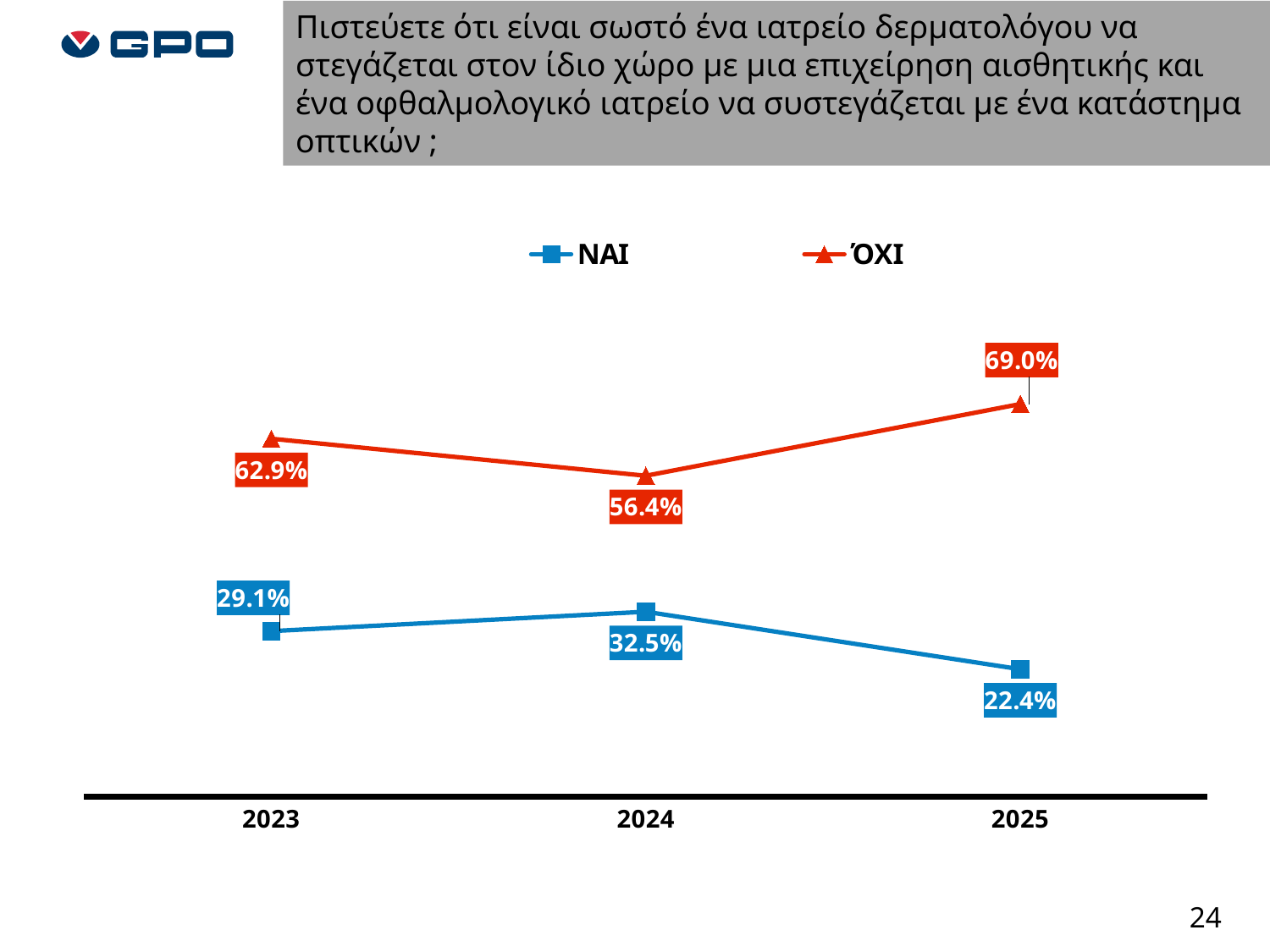
How many series does the legend list? 2 What is the value for ΝΑΙ in 2025? 22.4% What is the difference between the ΌΧΙ and ΝΑΙ values in 2025? 46.6% What is the value for ΌΧΙ in 2023? 62.9% Which is larger in 2024, the ΝΑΙ value or the ΌΧΙ value? ΌΧΙ What is the value for ΌΧΙ in 2025? 69.0% In which year is the ΌΧΙ value highest? 2025 How many years are shown on the x axis? 3 What kind of chart is shown on the slide? line chart In which year is the ΝΑΙ value lowest? 2025 Does the ΝΑΙ value rise or fall from 2024 to 2025? fall What is the value for ΝΑΙ in 2024? 32.5%